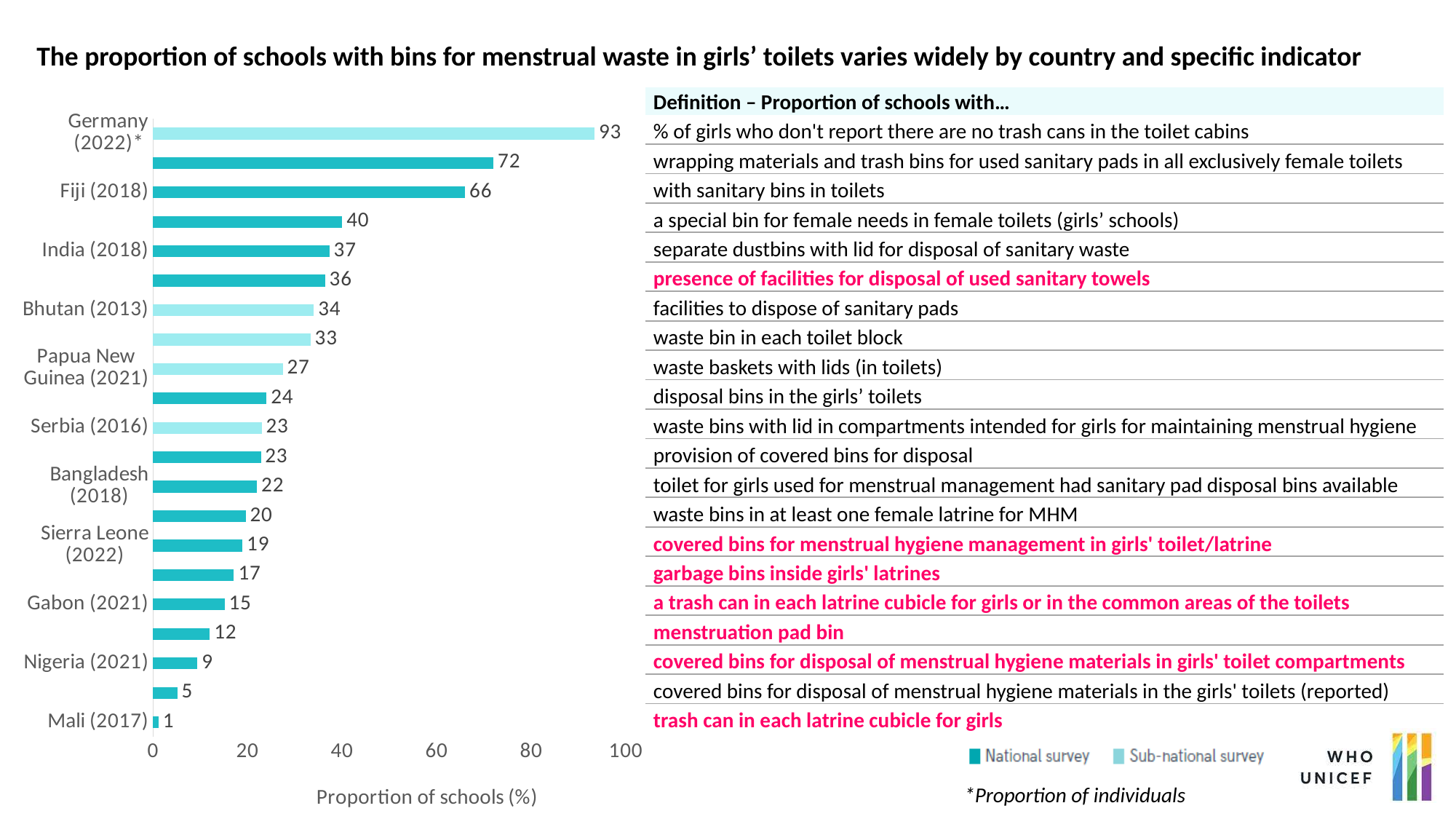
What is the value for Mali (2017)? 1 What is the value for Fiji (2018)? 66 Which labelled country has the lowest proportion of schools? Mali (2017) How many bars are plotted in the chart? 21 What is the difference between the values for Germany (2022)* and Fiji (2018)? 27 Which labelled country has the highest proportion of schools? Germany (2022)* How many series does the legend list? 2 Which is larger, the value for India (2018) or the value for Bhutan (2013)? India (2018) What is the value for Nigeria (2021)? 9 What is the value for Bhutan (2013)? 34 What is the value for Germany (2022)*? 93 What kind of chart is shown on the slide? Bar chart